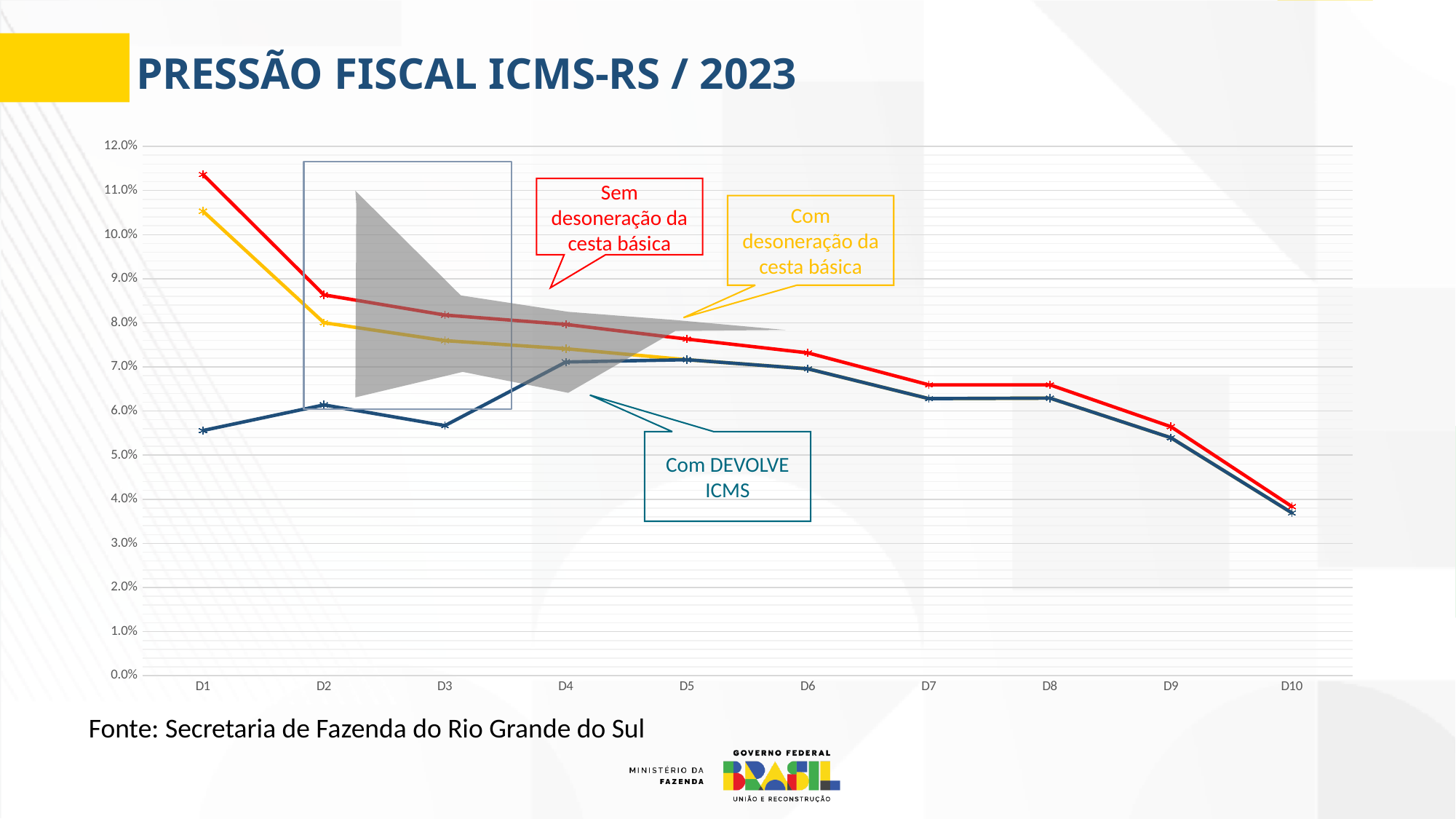
What is the title of the chart on the slide? PRESSÃO FISCAL ICMS-RS / 2023 How many categories are shown on the x axis of the chart? 10 Does the 'Sem desoneração da cesta básica' line rise or fall from D1 to D10? fall Is the value for 'Sem desoneração da cesta básica' at D1 greater or less than 11.0%? greater Is the value for 'Com DEVOLVE ICMS' at D1 greater or less than 6.0%? less What kind of chart is shown on the slide? line chart At D1, which series has the larger value: 'Sem desoneração da cesta básica' or 'Com DEVOLVE ICMS'? Sem desoneração da cesta básica For the 'Sem desoneração da cesta básica' series, which category has the highest value? D1 Is the value for 'Sem desoneração da cesta básica' at D10 greater or less than 5.0%? less How many data series are plotted on the chart? 3 For the 'Sem desoneração da cesta básica' series, which category has the lowest value? D10